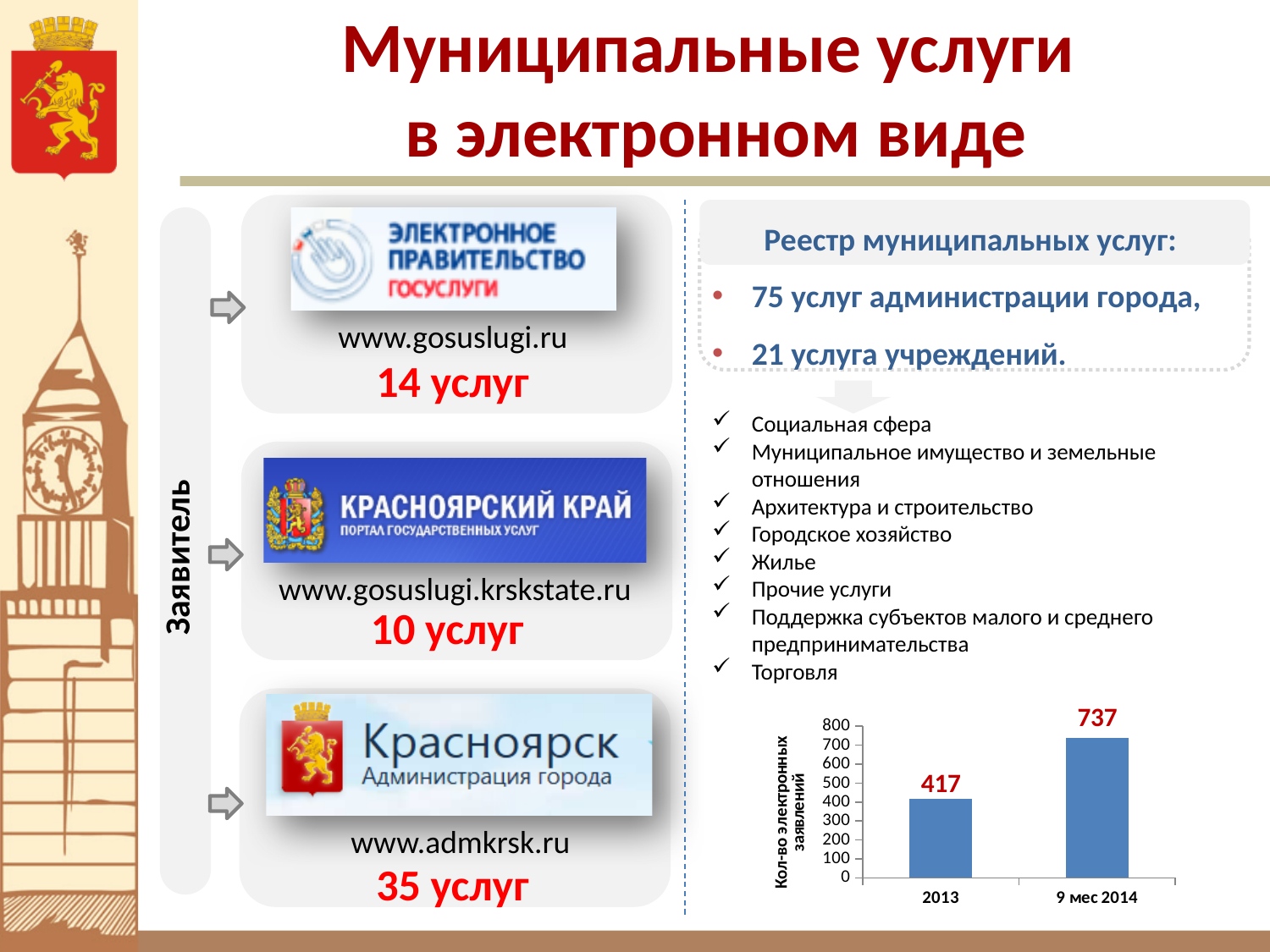
Which is larger in the bar chart: the value for 2013 or the value for 9 мес 2014? 9 мес 2014 How many categories are shown in the bar chart? 2 Which category has the highest value in the bar chart? 9 мес 2014 Is the value for 2013 in the bar chart greater or less than 500? less Do the values in the bar chart rise or fall from 2013 to 9 мес 2014? rise What is the value for 9 мес 2014 in the bar chart? 737 What kind of chart is shown on the slide? bar chart What is the label of the vertical axis of the bar chart? Кол-во электронных заявлений Is the value for 9 мес 2014 in the bar chart greater or less than 600? greater What is the value for 2013 in the bar chart? 417 Which category has the lowest value in the bar chart? 2013 What is the difference between the values for 9 мес 2014 and 2013 in the bar chart? 320